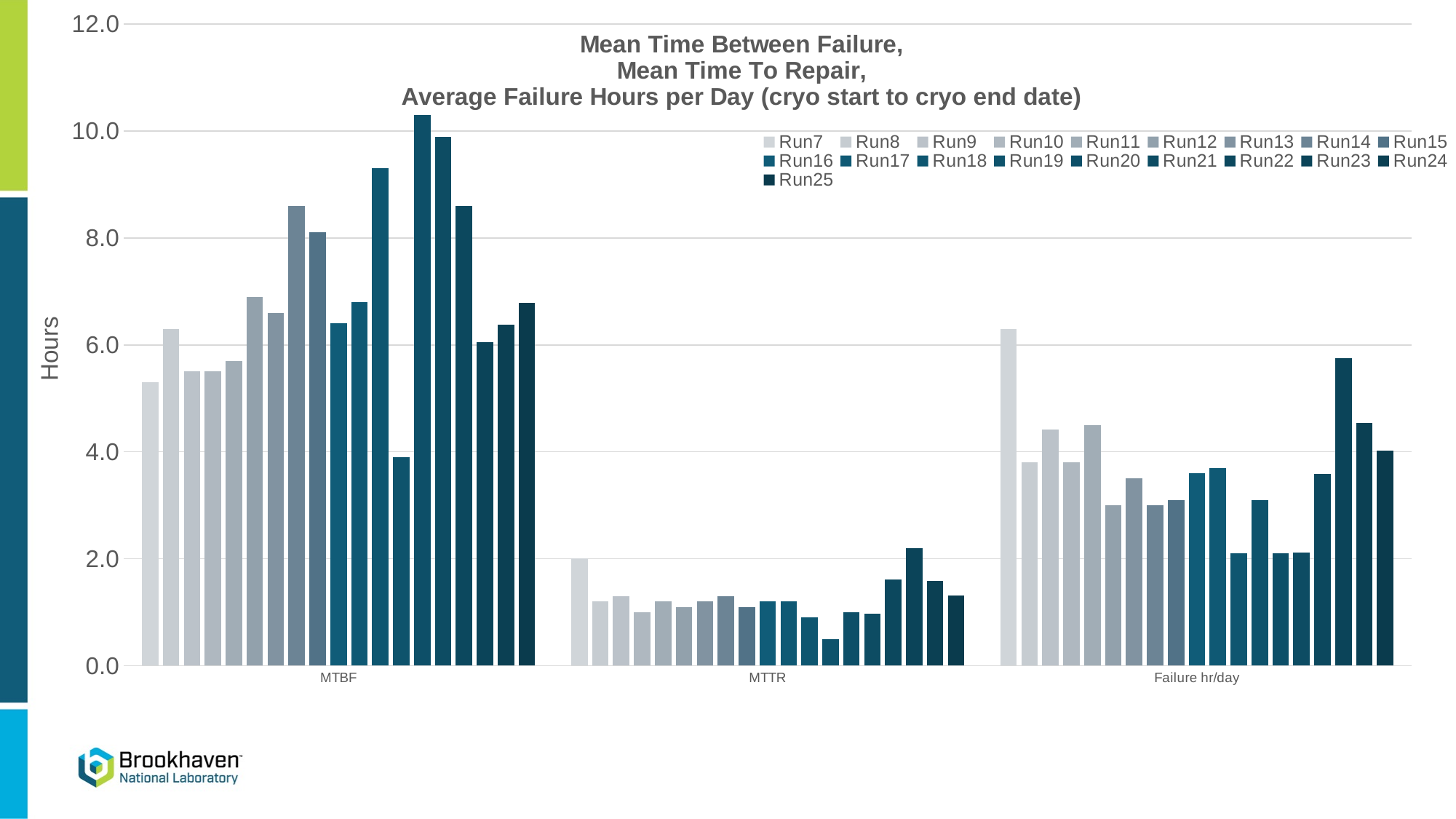
Which category has the lowest bars overall? MTTR What is the label of the y axis? Hours Is the tallest bar in the MTTR group greater or less than 4.0? less How many categories are shown on the x axis of the chart? 3 Is the leftmost (Run7) bar in the Failure hr/day group greater or less than 6.0? greater How many series does the chart's legend list? 19 Is the leftmost (Run7) bar in the MTBF group greater or less than 6.0? less What is the first series listed in the legend? Run7 What kind of chart is shown on the slide? bar chart Which category contains the tallest bar in the chart? MTBF Is the tallest bar in the Failure hr/day group larger or smaller than the tallest bar in the MTBF group? smaller